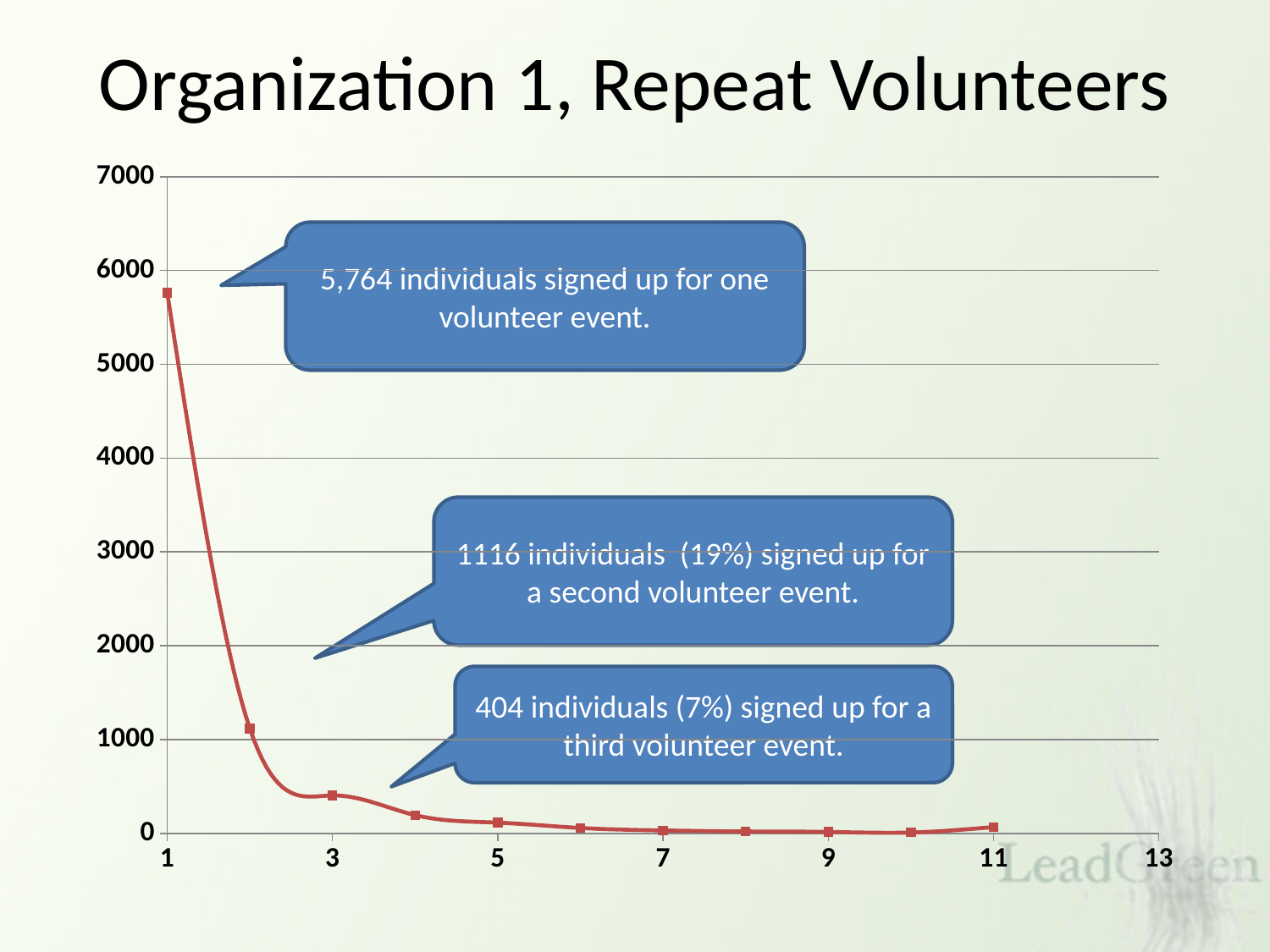
How many individuals signed up for one volunteer event, according to the callout? 5,764 What percentage of individuals signed up for a second volunteer event? 19% Is the value at x = 4 greater or less than 1000? less What kind of chart is shown on the slide? line chart What is the title of the chart on the slide? Organization 1, Repeat Volunteers At which x-axis value is the plotted value highest? 1 What percentage of individuals signed up for a third volunteer event? 7% What is the difference between the number of individuals who signed up for one event and those who signed up for a second event? 4648 Do the plotted values rise or fall as the x axis increases? fall How many data points are plotted on the line? 11 How many individuals signed up for a third volunteer event? 404 How many individuals signed up for a second volunteer event? 1116